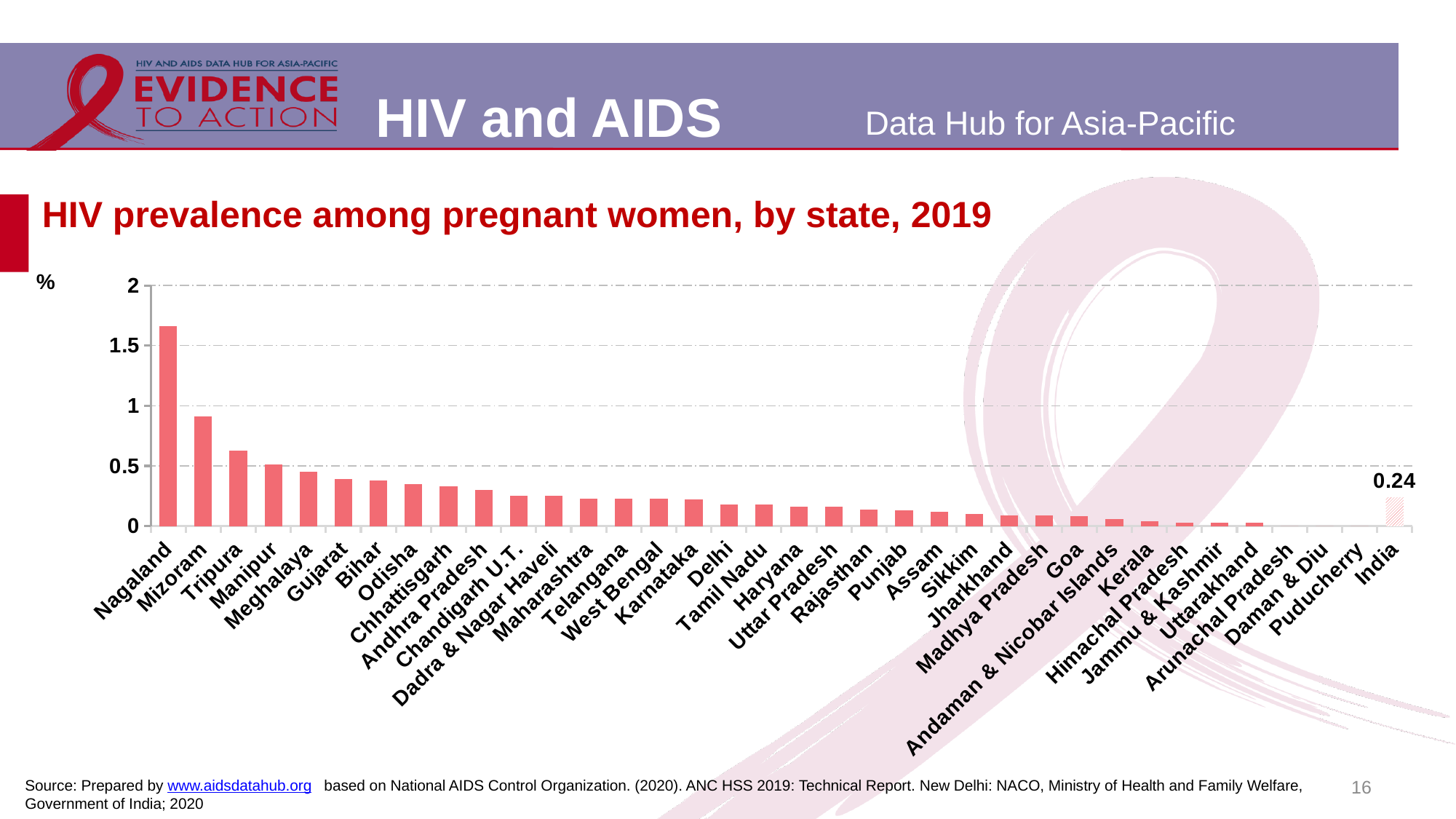
Is the value for Meghalaya greater or less than 0.5? less Is the value for Mizoram greater or less than 1? less What is the HIV prevalence among pregnant women for India, as labelled on the chart? 0.24 Which has a higher HIV prevalence among pregnant women, Nagaland or Mizoram? Nagaland Which state has the highest HIV prevalence among pregnant women in the chart? Nagaland Is the value for Nagaland greater or less than 1.5? greater Which has a higher HIV prevalence among pregnant women, Tripura or Gujarat? Tripura What unit is shown on the y axis of the chart? % What is the title of the chart? HIV prevalence among pregnant women, by state, 2019 Do the bar values generally rise or fall moving from left to right along the x axis? Fall What kind of chart is shown on the slide? Bar chart